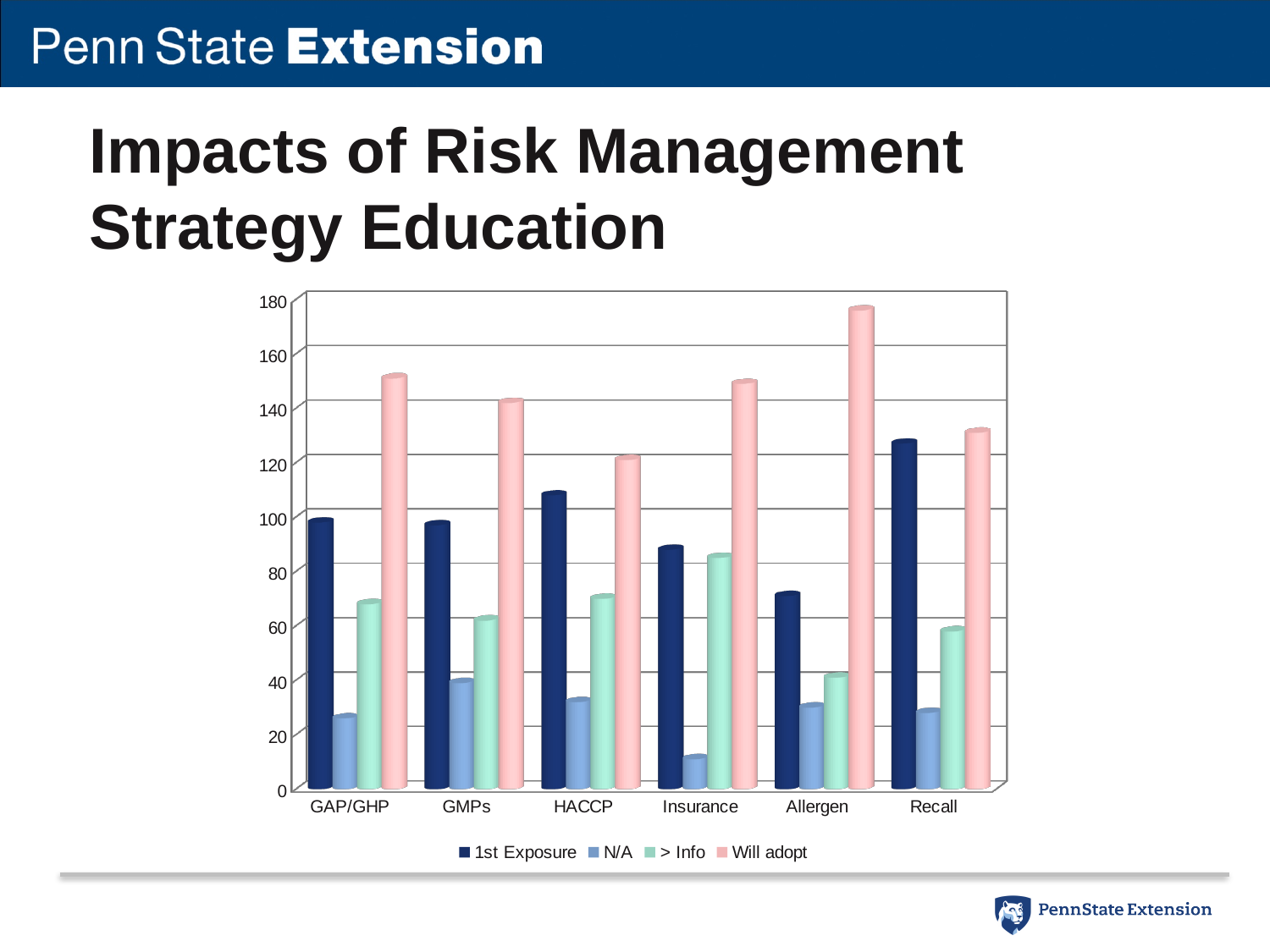
Which category has the lowest 'N/A' value? Insurance Is the 'Will adopt' value for Allergen greater or less than 160? greater Is the 'N/A' value for Insurance greater or less than 20? less Which category has the highest 'Will adopt' value? Allergen Which category has the lowest '1st Exposure' value? Allergen What kind of chart is shown on the slide? Bar chart Which category has the highest '1st Exposure' value? Recall How many categories are shown on the x axis of the chart? 6 Which is larger for GAP/GHP: the '> Info' value or the 'N/A' value? > Info Is the '1st Exposure' value for HACCP greater or less than 100? greater Which series is shown in pink in the chart legend? Will adopt How many series does the chart legend list? 4